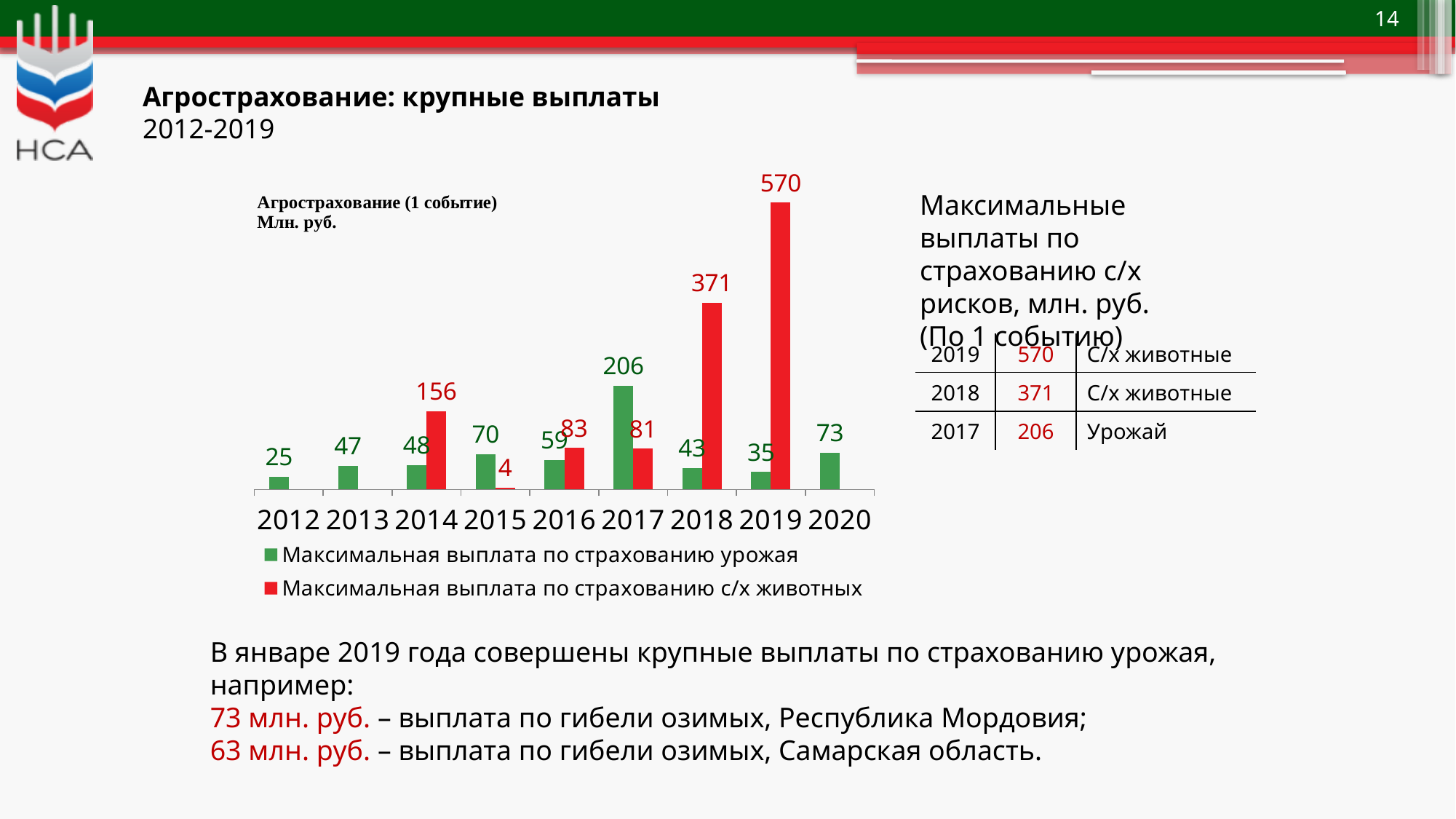
What type of chart is shown on the slide? Bar chart What is the difference between the livestock payout and the crop payout in 2018? 328 How many years are shown on the x axis of the chart? 9 Which is larger in 2017: the crop insurance payout or the livestock insurance payout? Crop insurance payout (206) Did the maximum livestock insurance payout rise or fall from 2017 to 2019? Rise In which year is the maximum livestock insurance payout (red series) highest? 2019 What is the maximum livestock insurance payout (red series) for 2019? 570 What is the maximum livestock insurance payout (red series) for 2015? 4 How many series does the chart legend list? 2 Which colour represents 'Максимальная выплата по страхованию с/х животных' in the chart? Red In which year is the maximum crop insurance payout (green series) lowest? 2012 What is the maximum crop insurance payout (green series) for 2017? 206